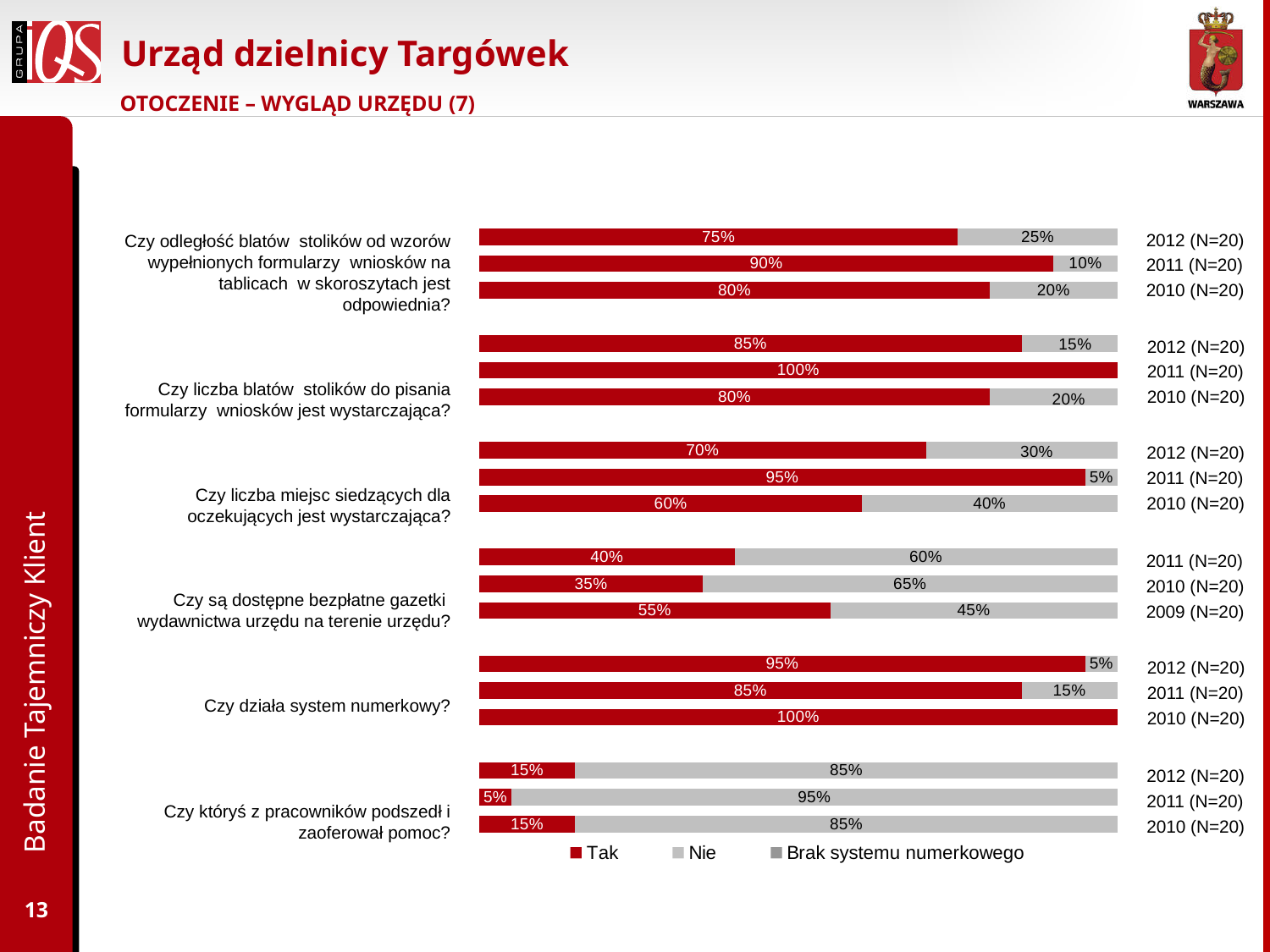
What is the difference between the "Tak" share in 2011 and 2012 for the question "Czy liczba miejsc siedzących dla oczekujących jest wystarczająca?" 25 percentage points What percentage answered "Tak" in 2012 to the question "Czy odległość blatów stolików od wzorów wypełnionych formularzy wniosków na tablicach w skoroszytach jest odpowiednia?" 75% What is the third legend entry in the chart? Brak systemu numerkowego How many series does the legend list? 3 What percentage answered "Tak" in 2011 to the question "Czy któryś z pracowników podszedł i zaoferował pomoc?" 5% What kind of chart is shown on the slide? stacked bar chart For the question "Czy liczba miejsc siedzących dla oczekujących jest wystarczająca?", which year had the highest "Tak" share? 2011 What is the sample size (N) shown for each bar in the chart? N=20 For the question "Czy działa system numerkowy?", is the "Tak" share larger in 2012 or in 2011? 2012 What percentage answered "Tak" in 2010 to the question "Czy działa system numerkowy?" 100% What percentage answered "Nie" in 2010 to the question "Czy liczba blatów stolików do pisania formularzy wniosków jest wystarczająca?" 20% For the question "Czy są dostępne bezpłatne gazetki wydawnictwa urzędu na terenie urzędu?", which year had the lowest "Tak" share? 2010